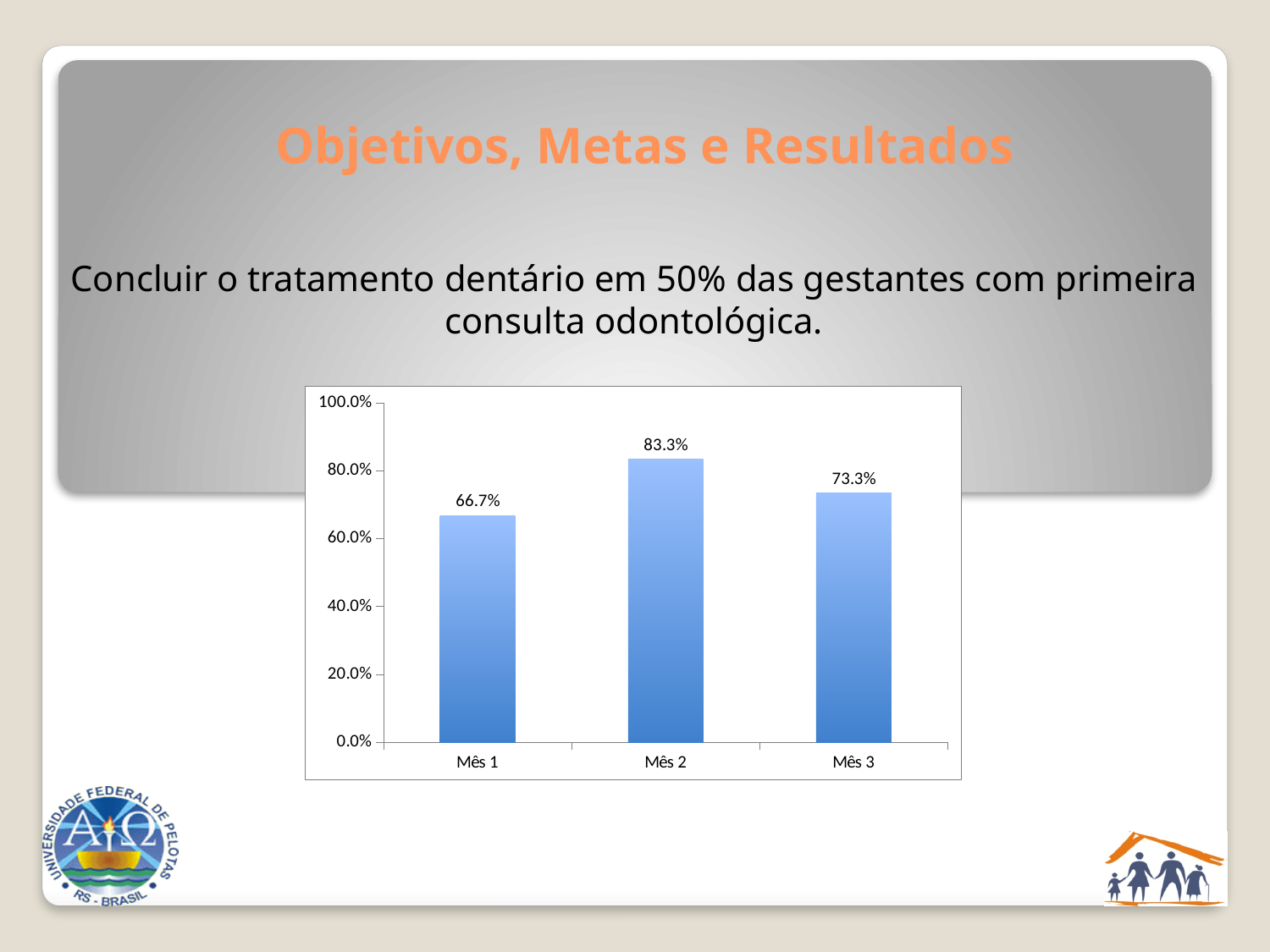
What kind of chart is shown on the slide? bar chart What is the difference between the values for Mês 2 and Mês 3? 10.0% Is the value for Mês 2 greater or less than 80.0%? greater Which month has the lowest value? Mês 1 What is the highest value shown on the y axis? 100.0% What is the difference between the values for Mês 2 and Mês 1? 16.6% What is the value for Mês 3? 73.3% How many categories are shown on the x axis? 3 What is the value for Mês 1? 66.7% Which month has the highest value? Mês 2 What is the value for Mês 2? 83.3% Which is larger, the value for Mês 3 or the value for Mês 1? Mês 3